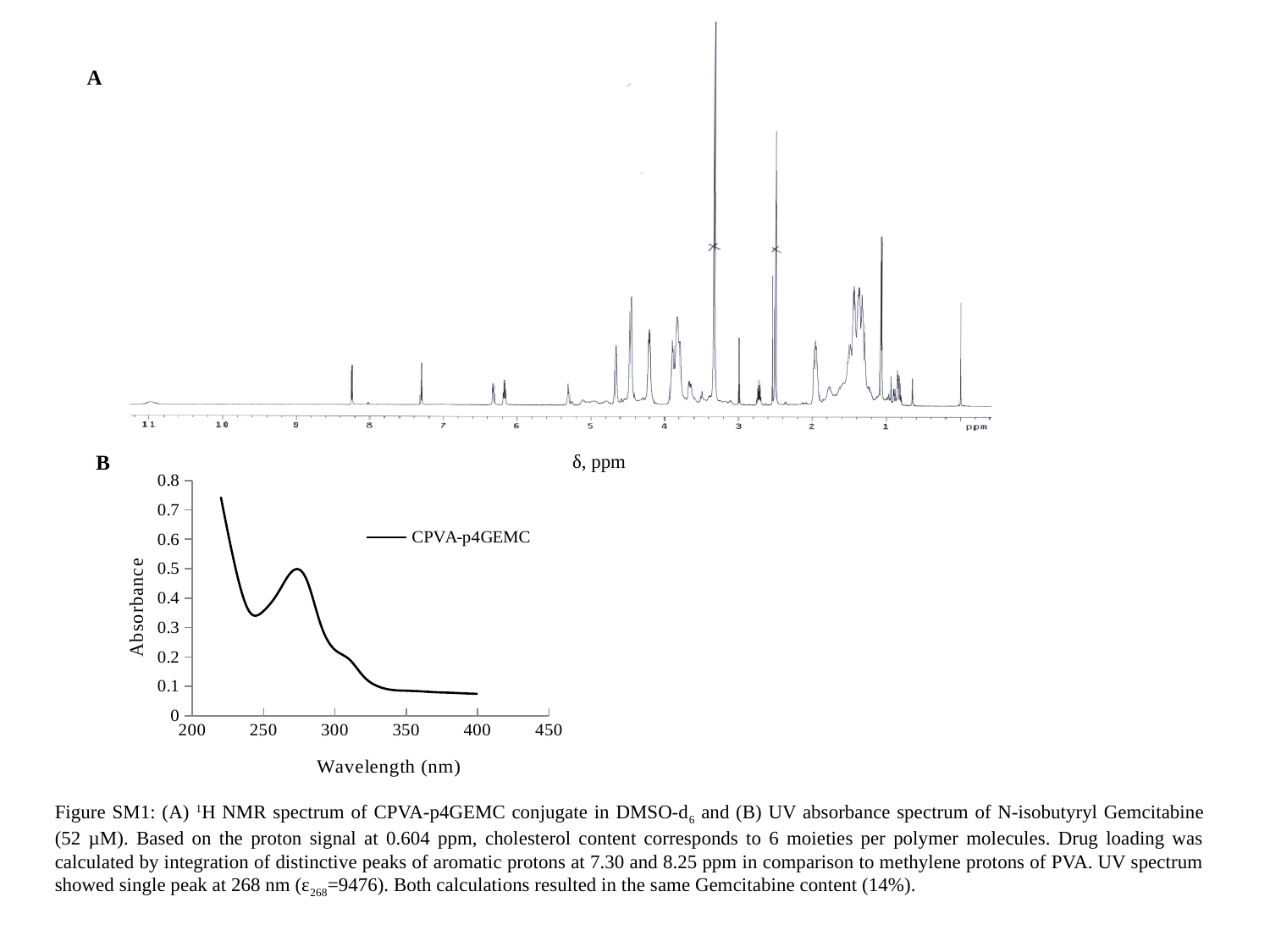
In chart B, does the absorbance rise or fall between 300 nm and 400 nm? fall In chart B, is the absorbance at 400 nm greater or less than 0.1? less How many series does the legend of chart B list? 1 In chart B, is the absorbance at 300 nm greater or less than 0.3? less In chart B, which wavelength has the higher absorbance, 250 nm or 350 nm? 250 nm What is the x-axis label of chart B? Wavelength (nm) In chart B, is the absorbance at 250 nm greater or less than 0.2? greater In chart B, does the absorbance rise or fall between 250 nm and 270 nm? rise What kind of chart is chart B (the UV absorbance spectrum)? line chart What is the name of the series shown in the legend of chart B? CPVA-p4GEMC